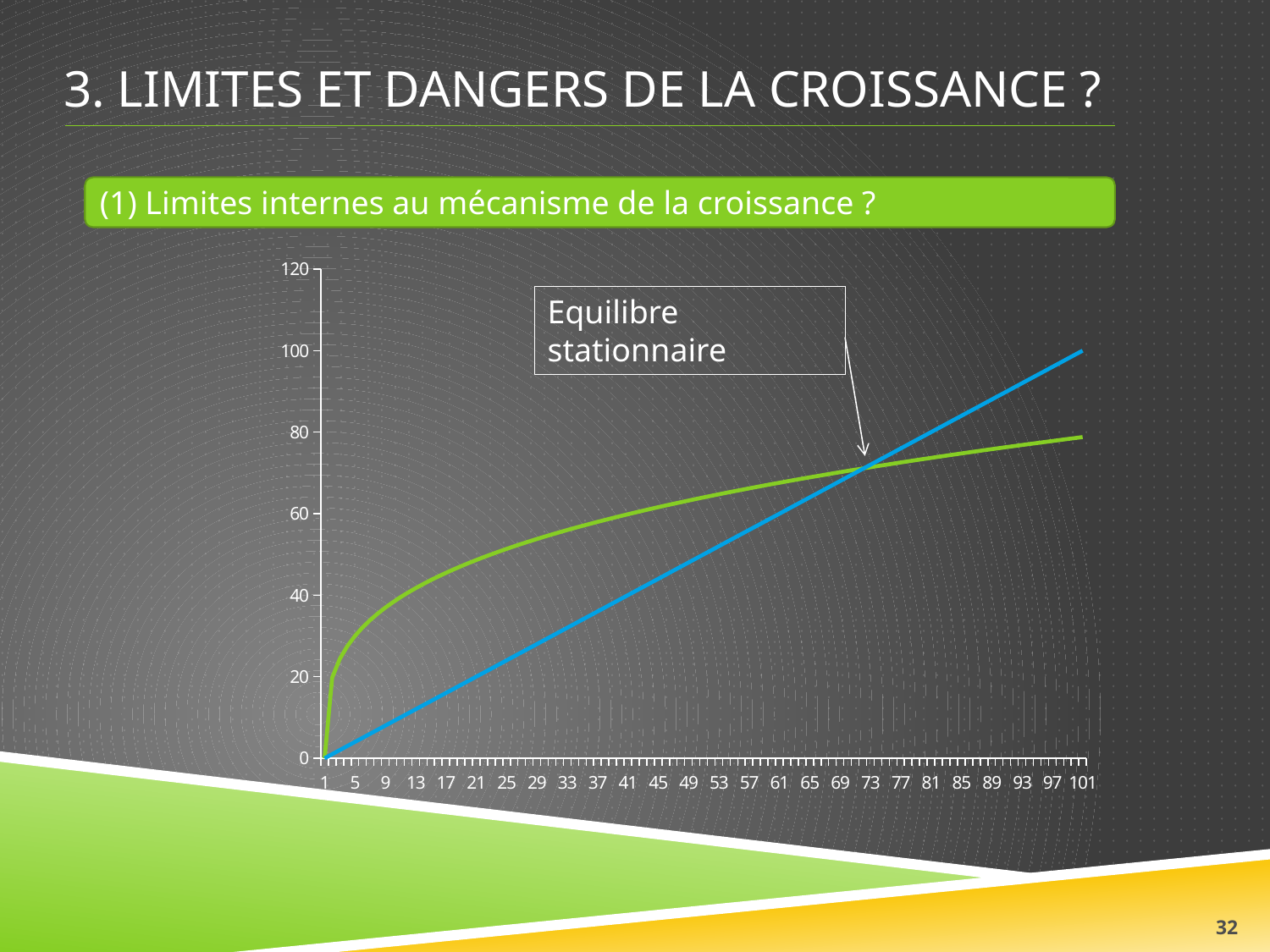
Is the value of the blue line at x = 21 greater or less than 40? less Does the green line rise or fall as the x axis increases? rise What is the highest value shown on the y axis? 120 Does the blue line rise or fall as the x axis increases? rise At x = 21, which line has the higher value, the green line or the blue line? green line What text is in the annotation box pointing to where the two lines cross? Equilibre stationnaire Is the value of the green line at x = 5 greater or less than 20? greater What is the last label shown on the x axis? 101 How many lines are plotted on the chart? 2 Is the value of the green line at x = 101 greater or less than 60? greater At x = 97, which line has the higher value, the green line or the blue line? blue line What kind of chart is shown on the slide? line chart